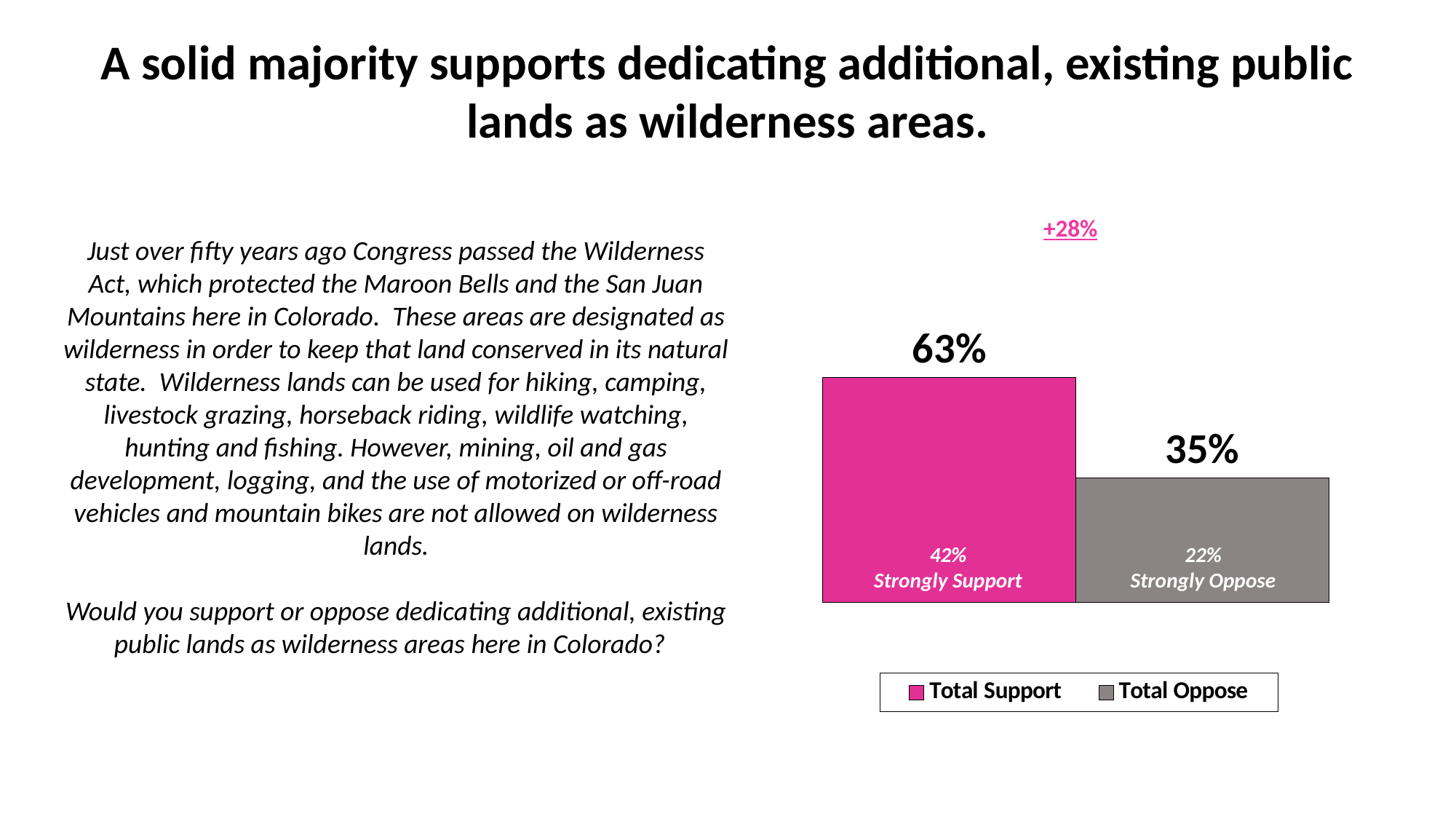
What percentage Strongly Support dedicating additional public lands as wilderness areas? 42% Is Strongly Support larger or smaller than Strongly Oppose? larger Which series has the higher value, Total Support or Total Oppose? Total Support What colour is the Total Support bar? pink What kind of chart is shown on the slide? bar chart How many series does the legend list? 2 What is the value for Total Oppose? 35% What is the value for Total Support? 63% What is the difference between Strongly Support and Strongly Oppose? 20% What percentage Strongly Oppose dedicating additional public lands as wilderness areas? 22% Which series has the lower value, Total Support or Total Oppose? Total Oppose What is the difference between Total Support and Total Oppose? 28%